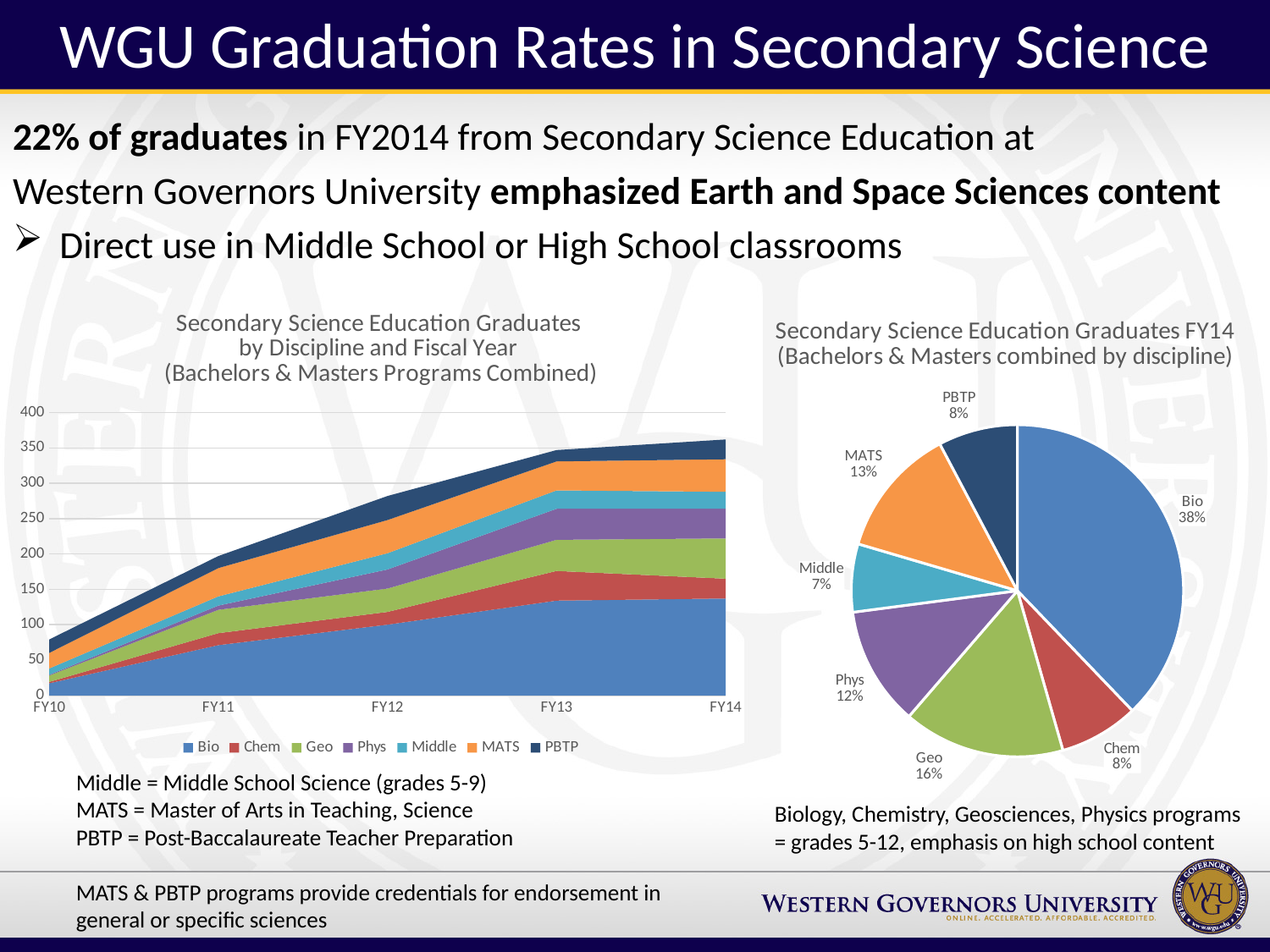
In the pie chart on the right, what percentage is shown for MATS? 13% In the left chart, is the total number of graduates in FY10 greater or less than 100? less In the left chart, does the total number of graduates rise or fall from FY10 to FY14? Rise In the pie chart on the right, what percentage of FY14 graduates is shown for Bio? 38% How many series does the legend of the left chart list? 7 In the pie chart on the right, which has a larger share, Geo or Phys? Geo What kind of chart is the chart on the left, titled 'Secondary Science Education Graduates by Discipline and Fiscal Year'? Stacked area chart How many slices does the pie chart on the right have? 7 In the pie chart on the right, how many percentage points larger is the Bio share than the Geo share? 22 percentage points In the pie chart on the right, which discipline has the largest slice? Bio In the pie chart on the right, which discipline has the smallest slice? Middle In the left chart, is the total number of graduates in FY14 greater or less than 300? greater